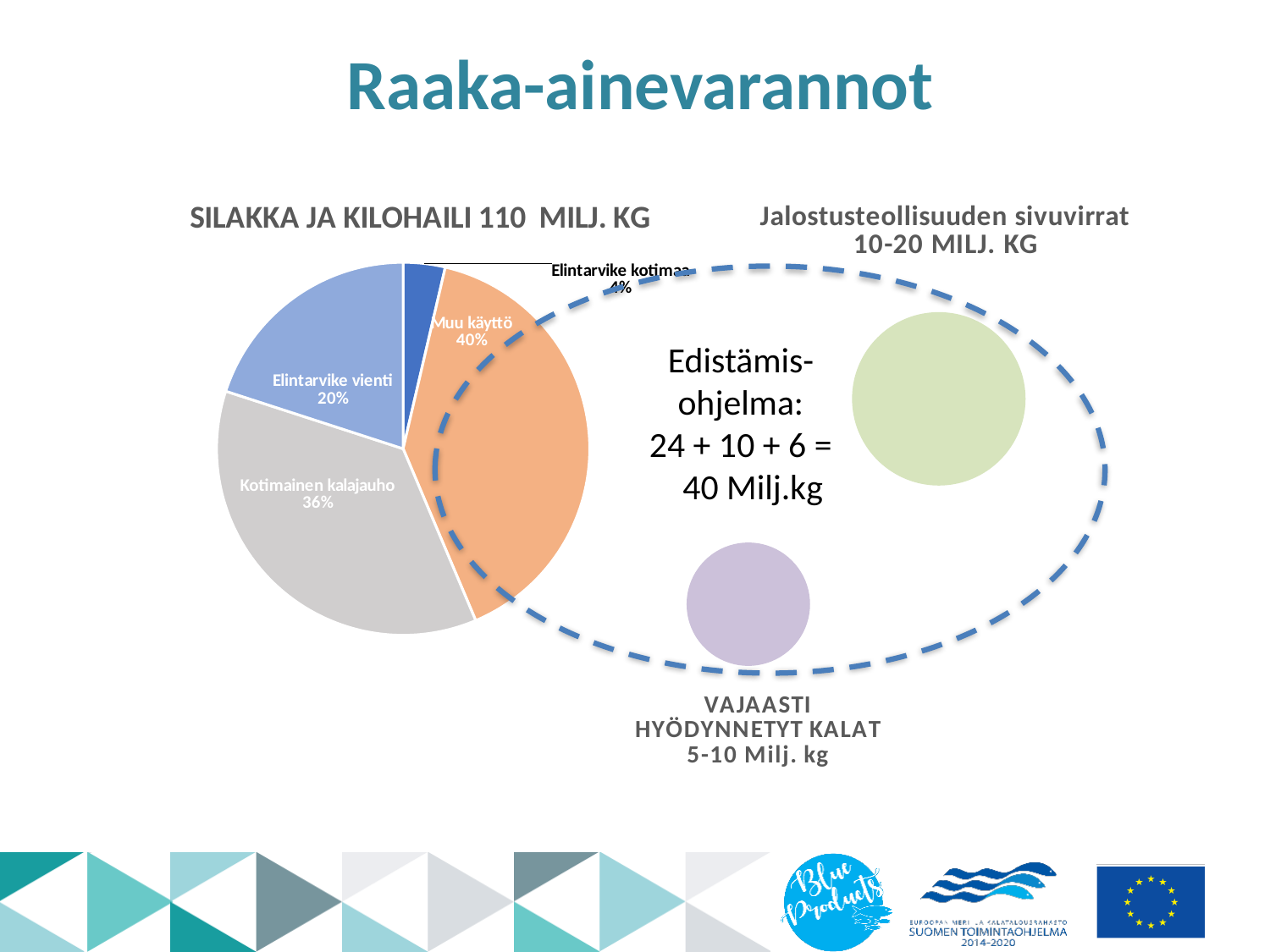
Which slice of the pie chart is the smallest? Elintarvike kotimaa What is the combined share of Muu käyttö and Kotimainen kalajauho? 76% What colour is the Muu käyttö slice? orange Which slice of the pie chart is the largest? Muu käyttö What percentage of the pie is Kotimainen kalajauho? 36% What is the title of the pie chart? SILAKKA JA KILOHAILI 110 MILJ. KG What percentage of the pie is Muu käyttö? 40% What is the difference in percentage points between Muu käyttö and Elintarvike vienti? 20 percentage points Which is larger, Kotimainen kalajauho or Elintarvike vienti? Kotimainen kalajauho What kind of chart is shown on the slide? pie chart What share of the pie does Elintarvike vienti represent? 20% How many slices does the pie chart have? 4